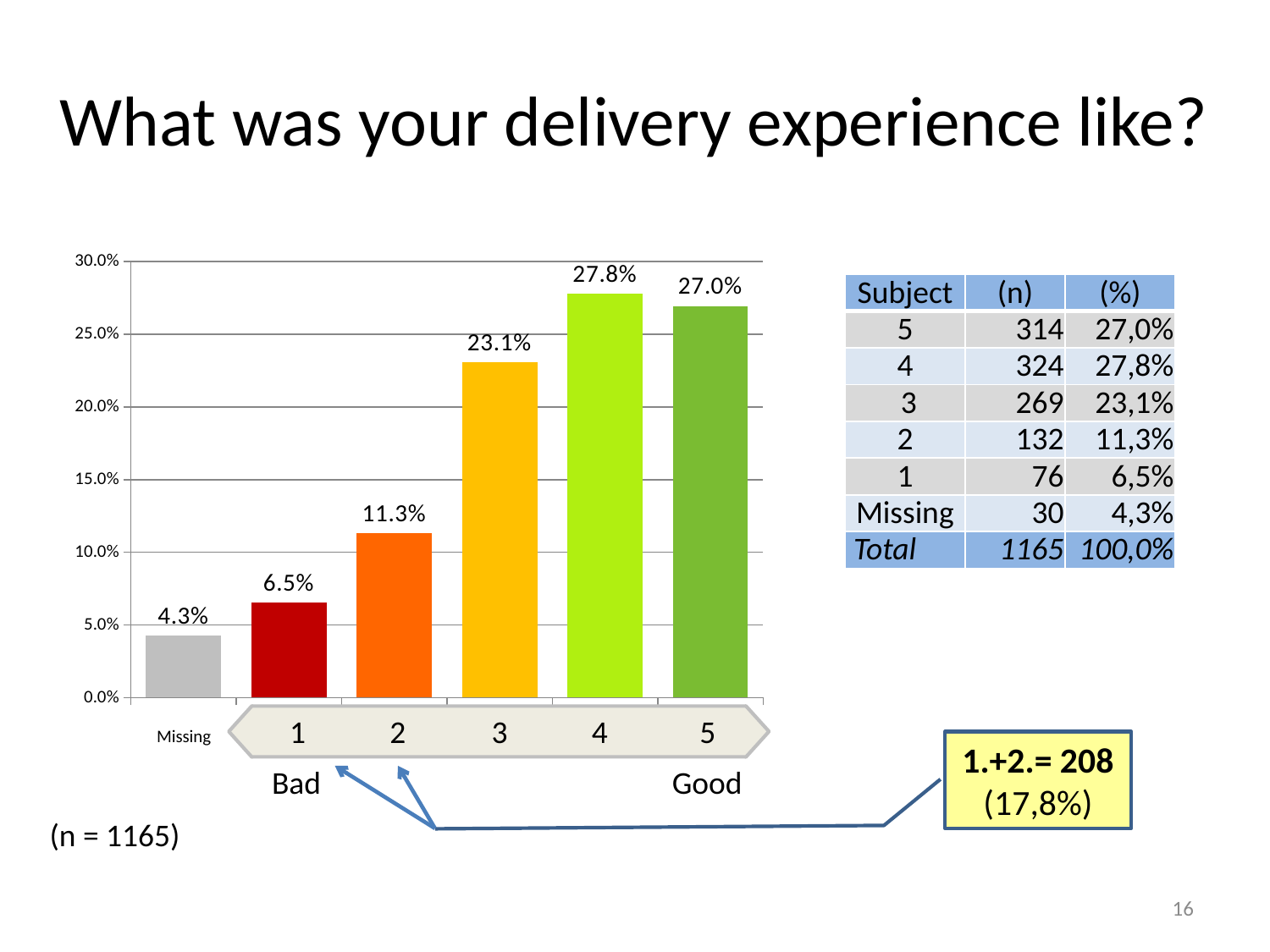
What is the title of the slide? What was your delivery experience like? What kind of chart is shown on the slide? bar chart What is the value for the Missing category? 4.3% What is the difference between the values for category 4 and category 5? 0.8% Which category has the lowest value? Missing What is the difference between the values for category 3 and category 2? 11.8% What is the value for category 3? 23.1% Which is larger, the value for category 2 or the value for category 1? 2 What is the value for category 1? 6.5% Is the value for category 3 greater or less than 20.0%? greater Which category has the highest value? 4 How many categories are shown on the x axis? 6